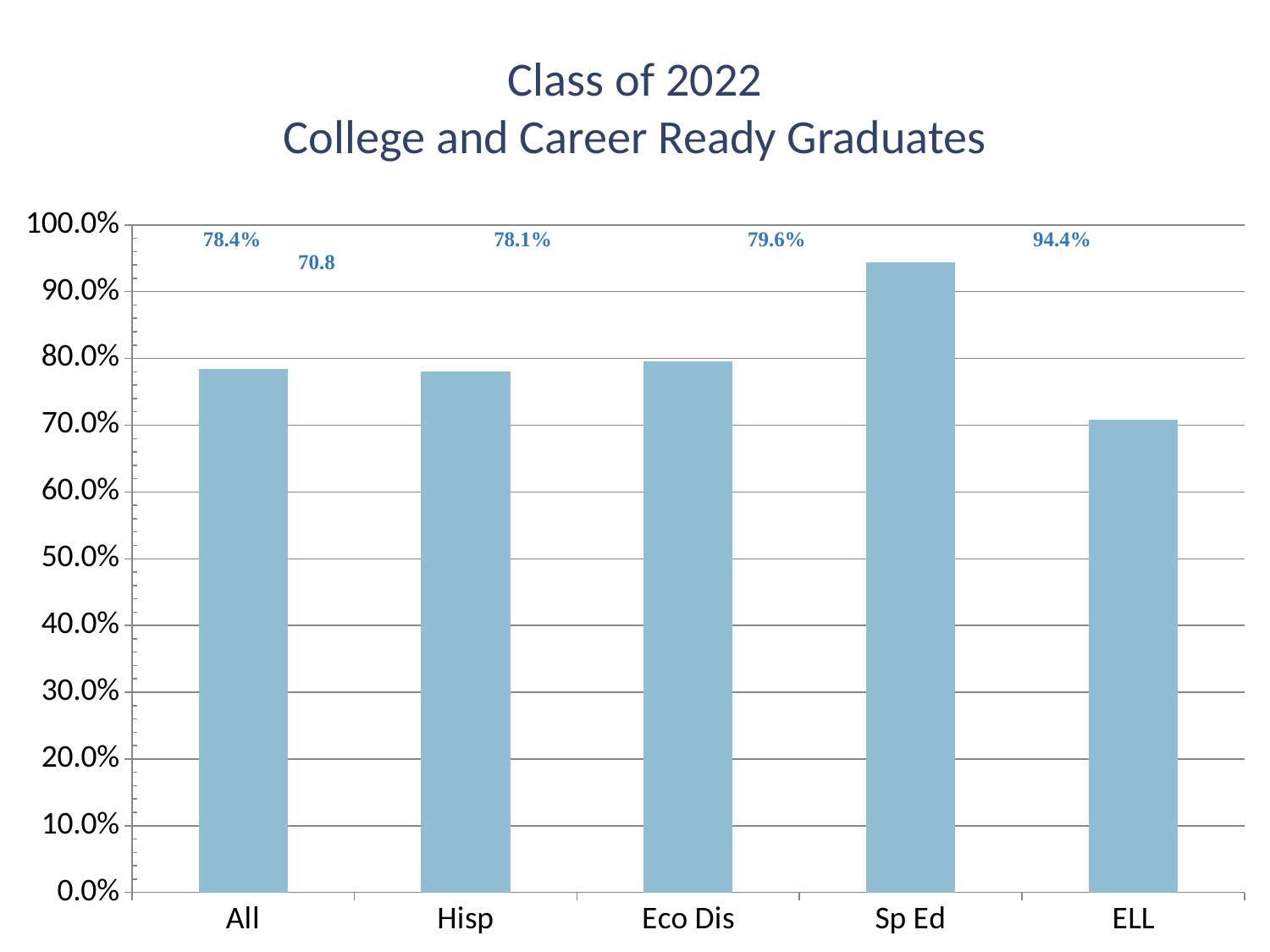
Is the value for ELL greater or less than 80.0%? less What is the value for Eco Dis? 79.6% What is the difference between the values for Sp Ed and All? 16.0% What is the value for Hisp? 78.1% What kind of chart is shown on the slide? bar chart What is the difference between the values for Eco Dis and Hisp? 1.5% How many categories are shown on the x axis? 5 Which category has the lowest value? ELL What is the value for Sp Ed? 94.4% What is the value for All? 78.4% Which is larger, the value for Eco Dis or the value for All? Eco Dis Which category has the highest value? Sp Ed